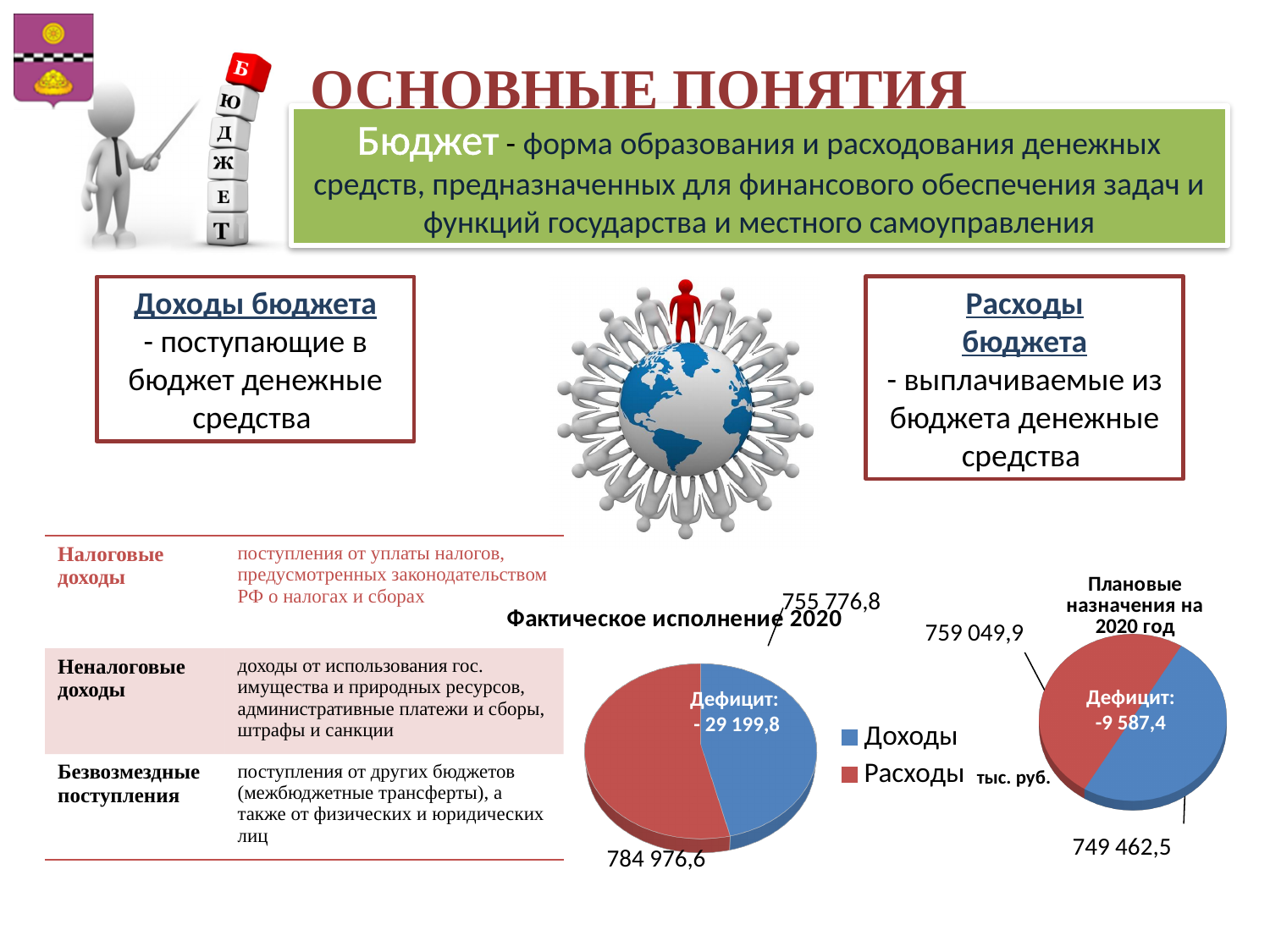
On the chart titled "Фактическое исполнение 2020", what is the difference between Расходы and Доходы? 29 199,8 What kind of chart is used for "Фактическое исполнение 2020"? Pie chart On the chart titled "Фактическое исполнение 2020", what is the value for Расходы? 784 976,6 On the chart titled "Плановые назначения на 2020 год", what is the difference between Расходы and Доходы? 9 587,4 On the chart titled "Плановые назначения на 2020 год", what is the value for Доходы? 749 462,5 On the chart titled "Плановые назначения на 2020 год", which is larger, Доходы or Расходы? Расходы Which colour represents Расходы in the pie charts' legend? Red On the chart titled "Фактическое исполнение 2020", which is larger, Доходы or Расходы? Расходы What deficit value is printed on the chart titled "Фактическое исполнение 2020"? - 29 199,8 On the chart titled "Фактическое исполнение 2020", what is the value for Доходы? 755 776,8 On the chart titled "Плановые назначения на 2020 год", what is the value for Расходы? 759 049,9 How many series does the legend shared by the two pie charts list? 2